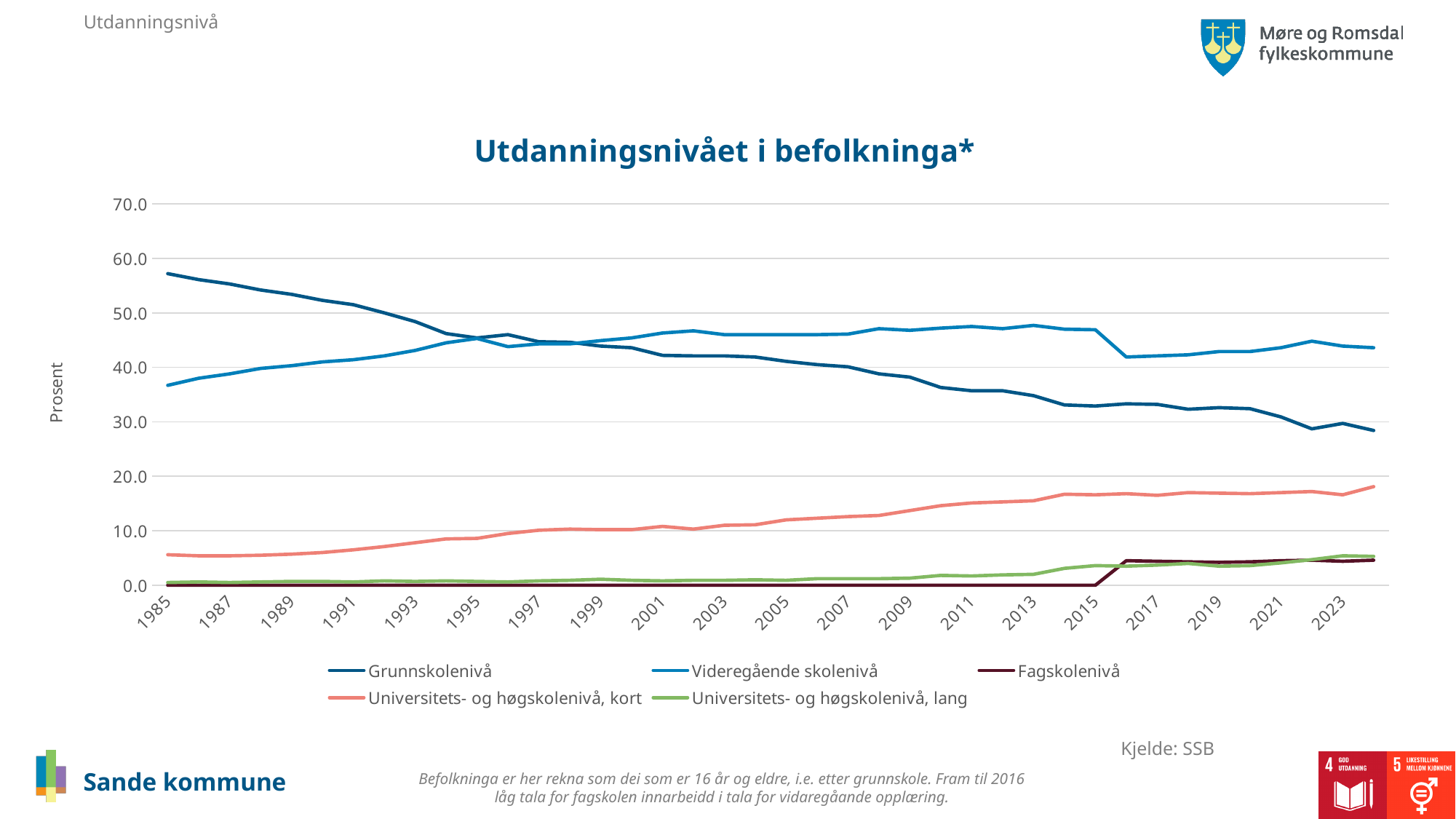
How many series does the legend list? 5 Does the Grunnskolenivå line rise or fall from 1985 to 2023? fall Is the value for Videregående skolenivå in 1985 greater or less than 40? less Is the value for Grunnskolenivå in 1985 greater or less than 50? greater Is the value for Videregående skolenivå in 2011 greater or less than 40? greater What kind of chart is shown on the slide? line chart Which series has the highest value in 2023? Videregående skolenivå What is the title of the chart? Utdanningsnivået i befolkninga* What is the label on the vertical axis? Prosent In 1985, which is larger: Grunnskolenivå or Videregående skolenivå? Grunnskolenivå